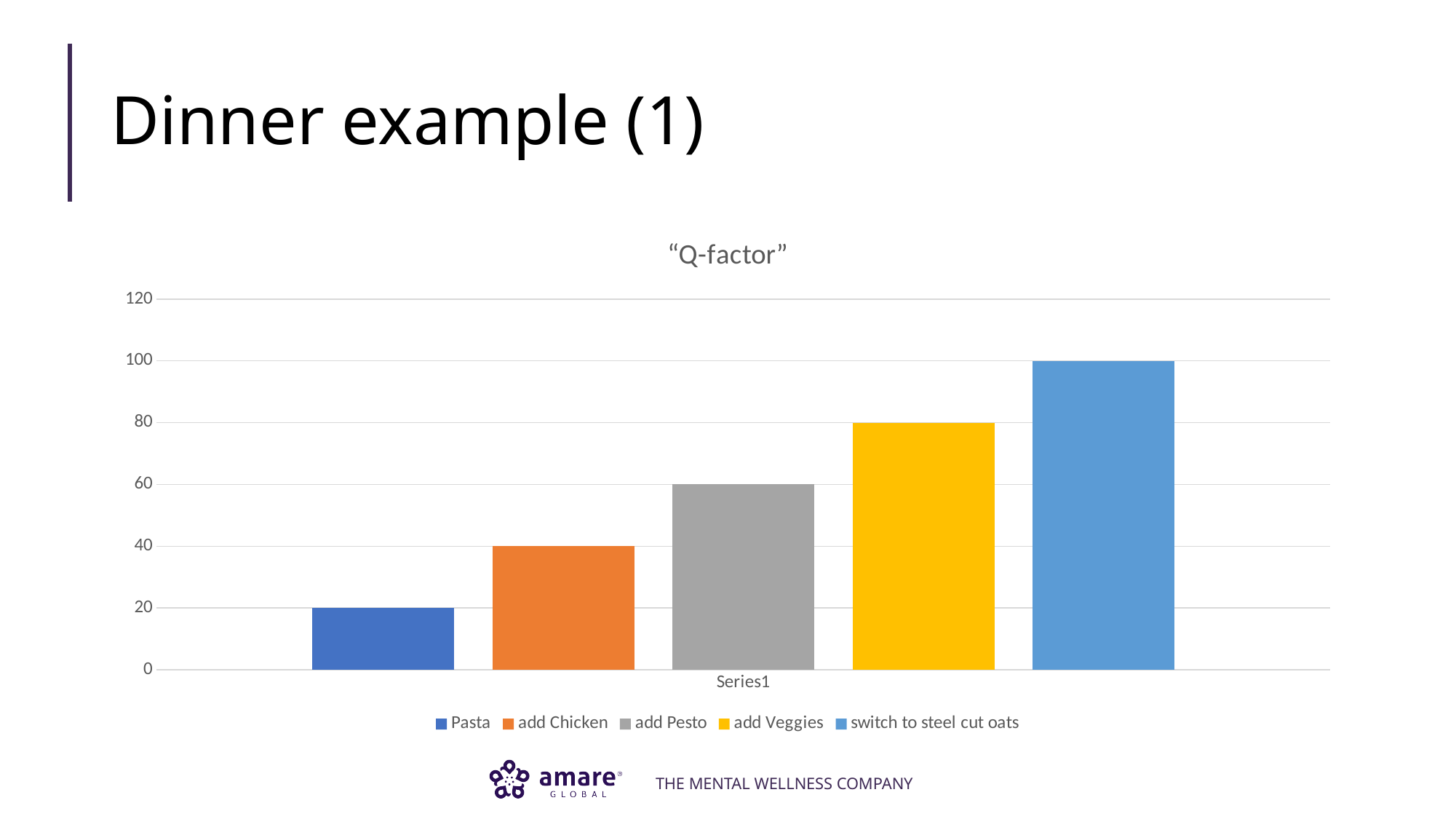
What is the difference between the values for add Veggies and add Pesto? 20 What is the value for switch to steel cut oats? 100 What kind of chart is shown? bar chart Is the value for add Veggies greater or less than 60? greater What is the value for Pasta? 20 Do the bar values rise or fall from left to right? rise What is the title of the chart? "Q-factor" How many series does the legend list? 5 What is the value for add Chicken? 40 Which is larger, the value for add Chicken or the value for add Pesto? add Pesto Which series has the lowest value? Pasta Which series has the highest value? switch to steel cut oats